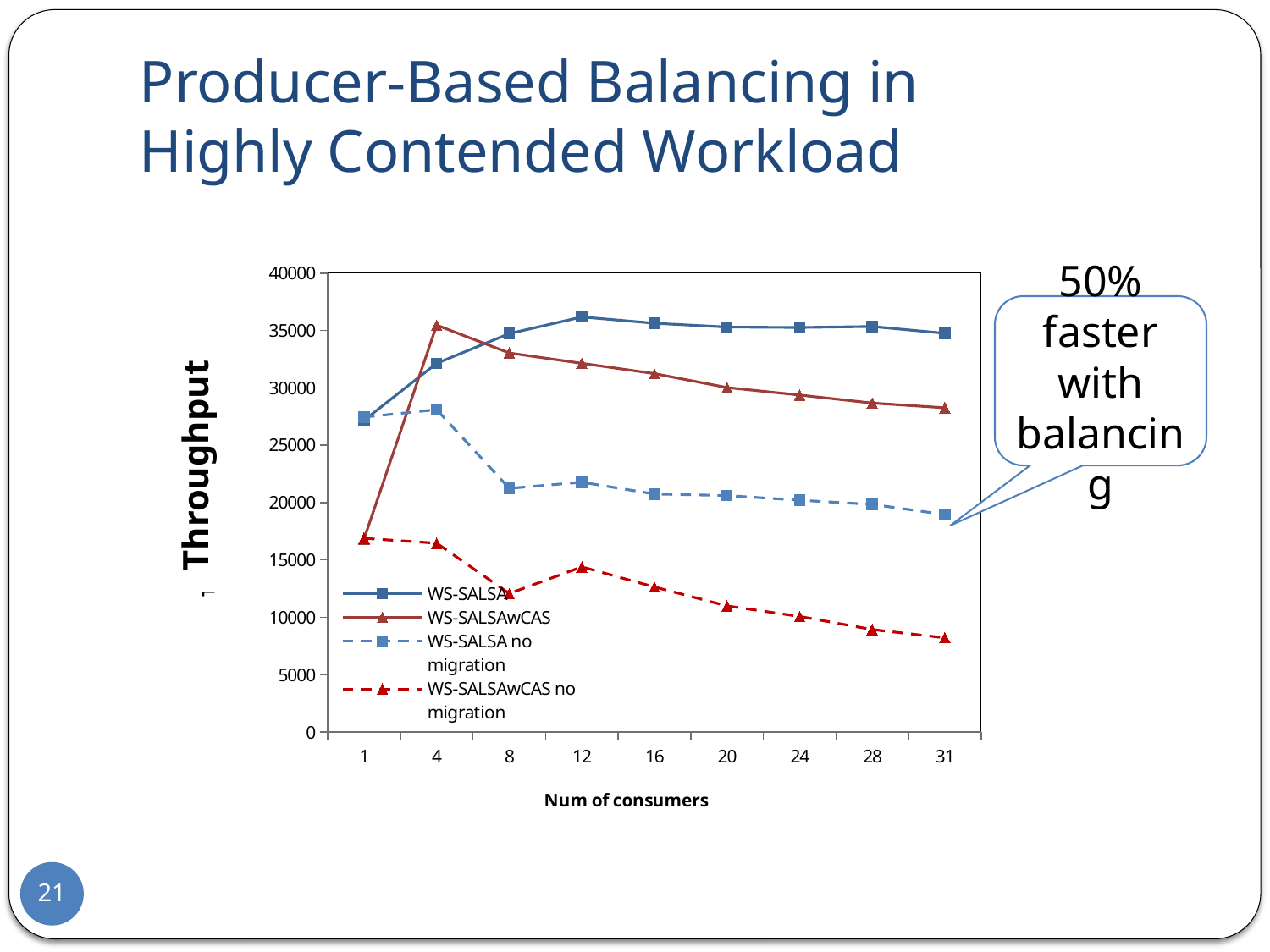
How many series does the legend list? 4 Does the throughput for WS-SALSAwCAS no migration rise or fall from 12 to 31 consumers? fall Which series has the highest throughput at 31 consumers? WS-SALSA Is the throughput for WS-SALSA at 12 consumers greater or less than 35000? greater Which series has the lowest throughput at 31 consumers? WS-SALSAwCAS no migration Is the throughput for WS-SALSAwCAS at 1 consumer greater or less than 20000? less Is the throughput for WS-SALSA no migration at 8 consumers greater or less than 25000? less At 4 consumers, which has the higher throughput: WS-SALSA or WS-SALSAwCAS? WS-SALSAwCAS What is the title of the x axis? Num of consumers What kind of chart is shown on the slide? line chart How many values of Num of consumers are plotted along the x axis? 9